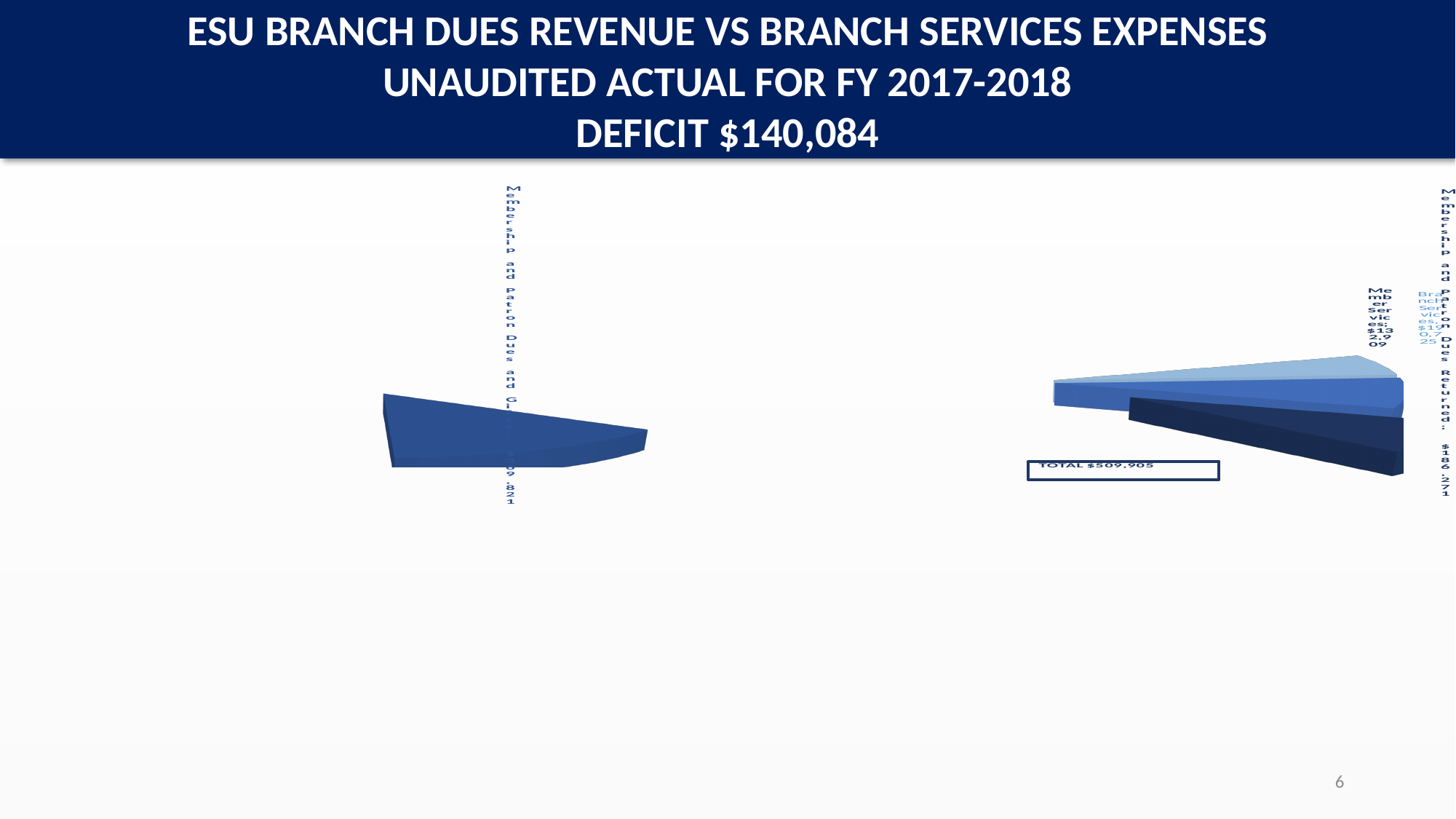
What deficit amount is stated in the slide title? $140,084 In the right-hand pie chart, which category has the smallest value? Member Services In the right-hand pie chart, what is the difference between Membership and Patron Dues Returned and Member Services? $53,362 Which fiscal year does the slide title say the unaudited actuals are for? FY 2017-2018 What kind of chart is shown on the right side of the slide? pie chart How many slices does the left-hand pie chart show? 1 In the right-hand pie chart, what is the value for Member Services? $132,909 In the right-hand pie chart, what is the value for Membership and Patron Dues Returned? $186,271 In the right-hand pie chart, what total is printed in the box below the chart? TOTAL $509,905 In the right-hand pie chart, what is the value for Branch Services? $190,725 In the right-hand pie chart, how many slices are there? 3 In the right-hand pie chart, which is larger: Member Services or Membership and Patron Dues Returned? Membership and Patron Dues Returned